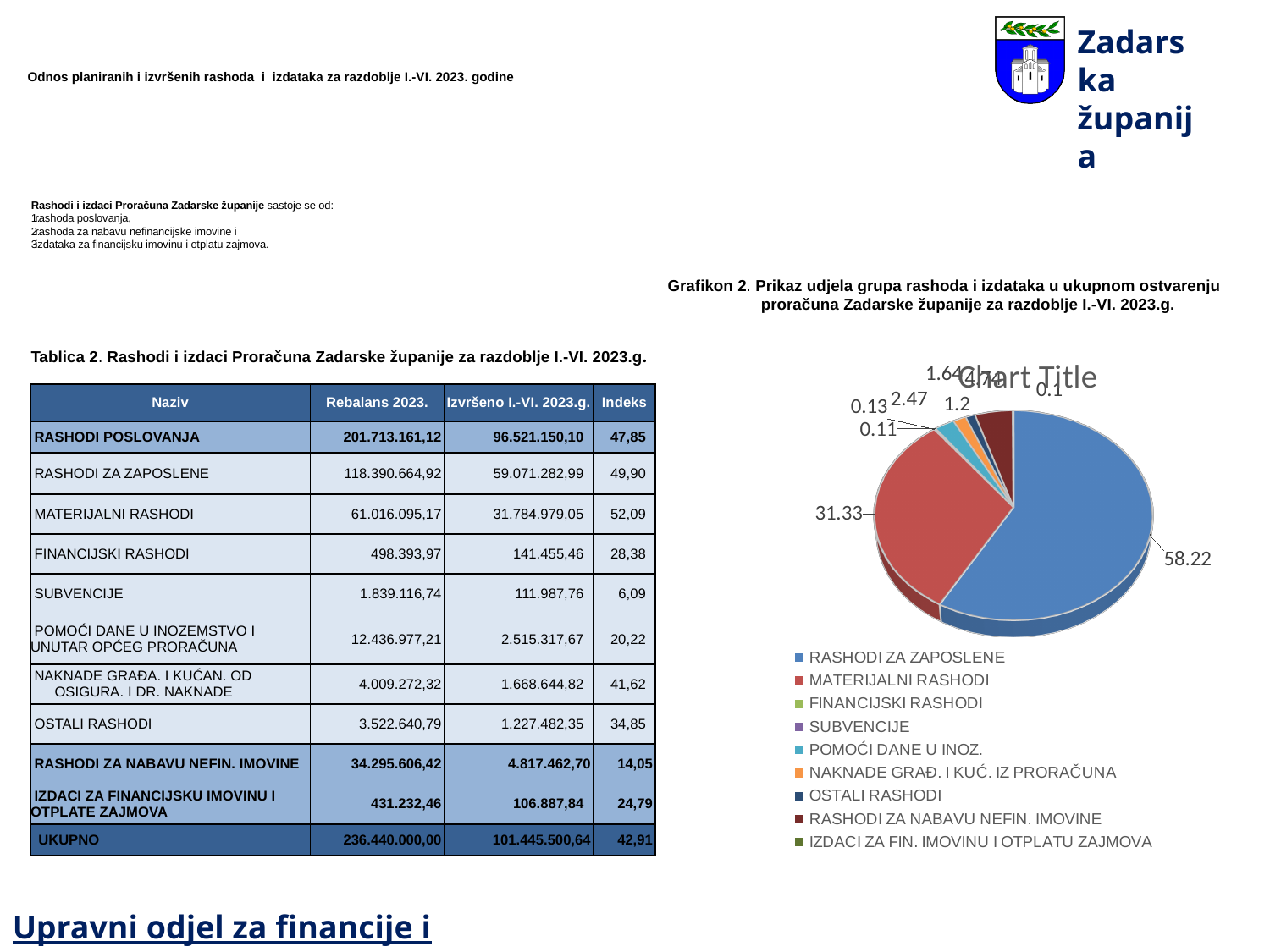
What is the value shown for RASHODI ZA ZAPOSLENE in the pie chart? 58.22 What is the combined value of the RASHODI ZA ZAPOSLENE and MATERIJALNI RASHODI slices? 89.55 What is the value shown for MATERIJALNI RASHODI in the pie chart? 31.33 What colour is the RASHODI ZA ZAPOSLENE slice in the pie chart? blue How many entries does the pie chart legend list? 9 What is the smallest value printed as a data label on the pie chart? 0.1 Which is larger in the pie chart, RASHODI ZA ZAPOSLENE or MATERIJALNI RASHODI? RASHODI ZA ZAPOSLENE Is the value for RASHODI ZA ZAPOSLENE greater or less than 50? greater What is the title shown on the pie chart? Chart Title What type of chart is shown on the slide? pie chart What is the difference between the RASHODI ZA ZAPOSLENE slice (58.22) and the MATERIJALNI RASHODI slice (31.33)? 26.89 Which category has the largest slice in the pie chart? RASHODI ZA ZAPOSLENE